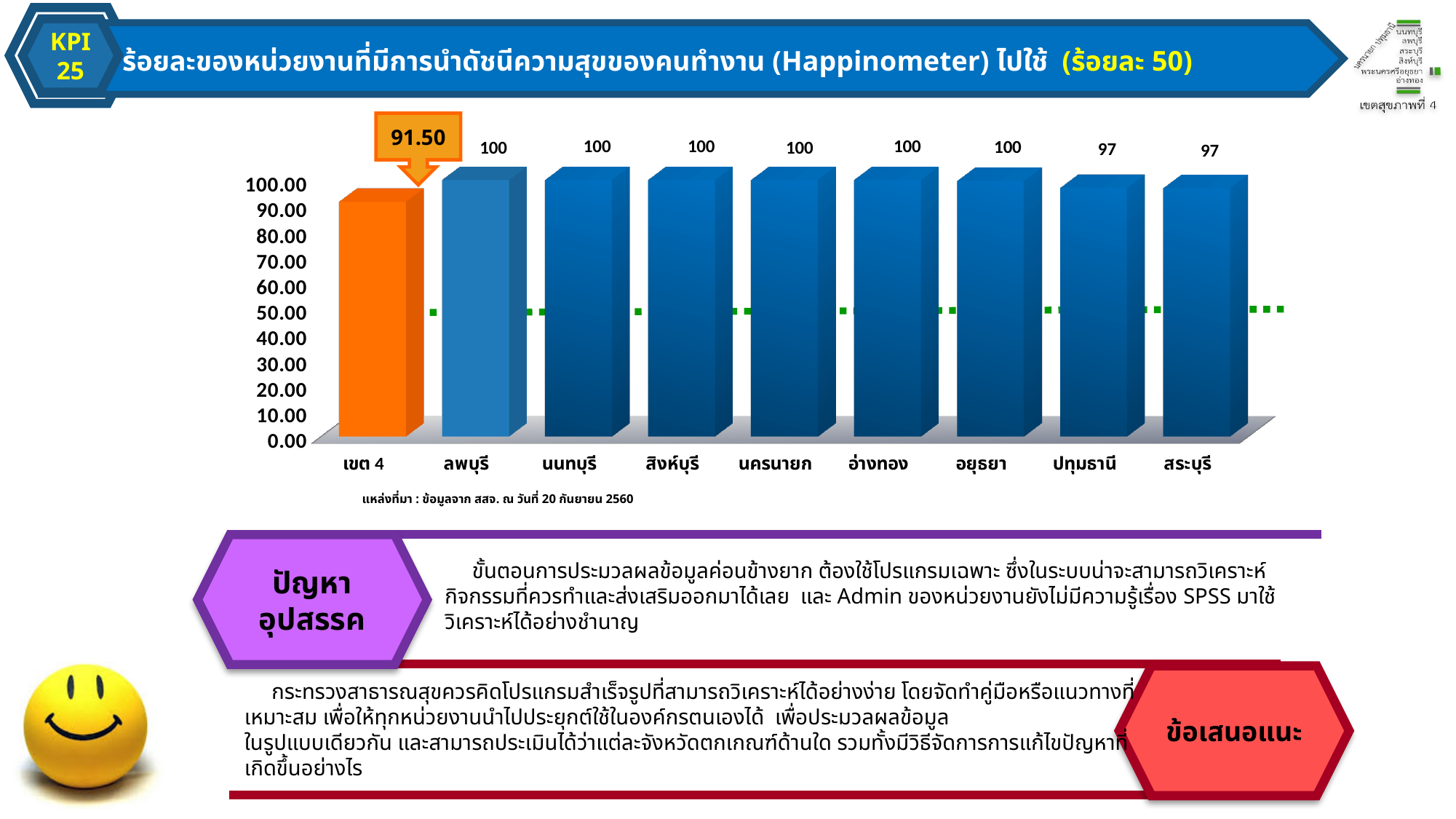
Which category has the lowest value? เขต 4 Is the value for เขต 4 greater or less than 50? greater How many categories are shown on the x axis? 9 What is the value for สระบุรี? 97 What is the value for เขต 4? 91.50 What is the value for ปทุมธานี? 97 What is the difference between the value for อยุธยา and the value for ปทุมธานี? 3 What kind of chart is shown on the slide? bar chart What colour is the bar for เขต 4? orange What is the value for ลพบุรี? 100 Which is larger, the value for นนทบุรี or the value for สระบุรี? นนทบุรี What is the difference between the value for ลพบุรี and the value for เขต 4? 8.50